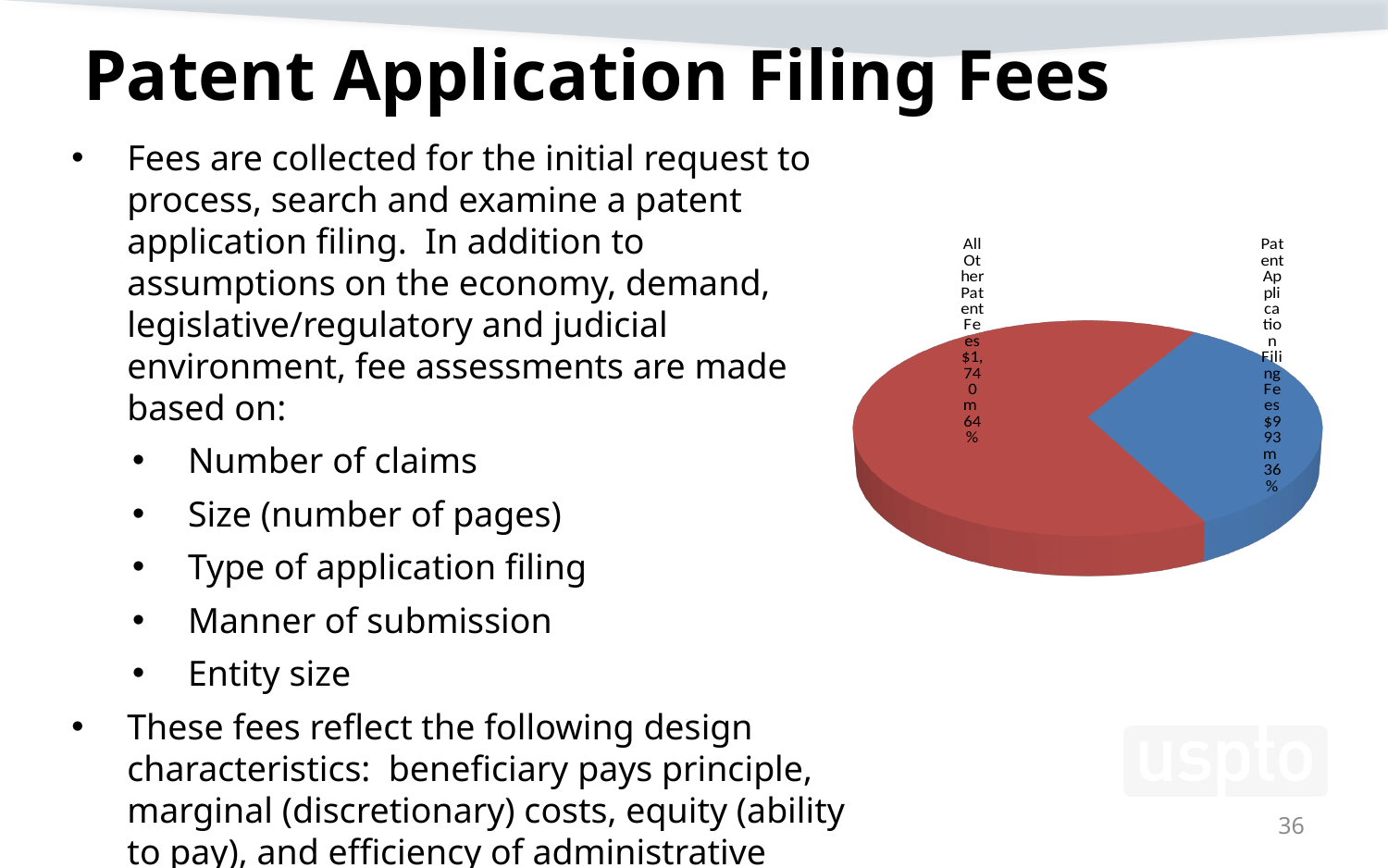
What percentage of the pie is All Other Patent Fees? 64% Which slice of the pie chart is the smallest? Patent Application Filing Fees Which slice of the pie chart is the largest? All Other Patent Fees What colour is the Patent Application Filing Fees slice? blue Which is larger, All Other Patent Fees or Patent Application Filing Fees? All Other Patent Fees What is the difference in percentage points between All Other Patent Fees and Patent Application Filing Fees? 28 What dollar amount is shown for Patent Application Filing Fees? $993m What colour is the All Other Patent Fees slice? red How many slices does the pie chart have? 2 What kind of chart is shown on the slide? pie chart What dollar amount is shown for All Other Patent Fees? $1,740m What percentage of the pie is Patent Application Filing Fees? 36%